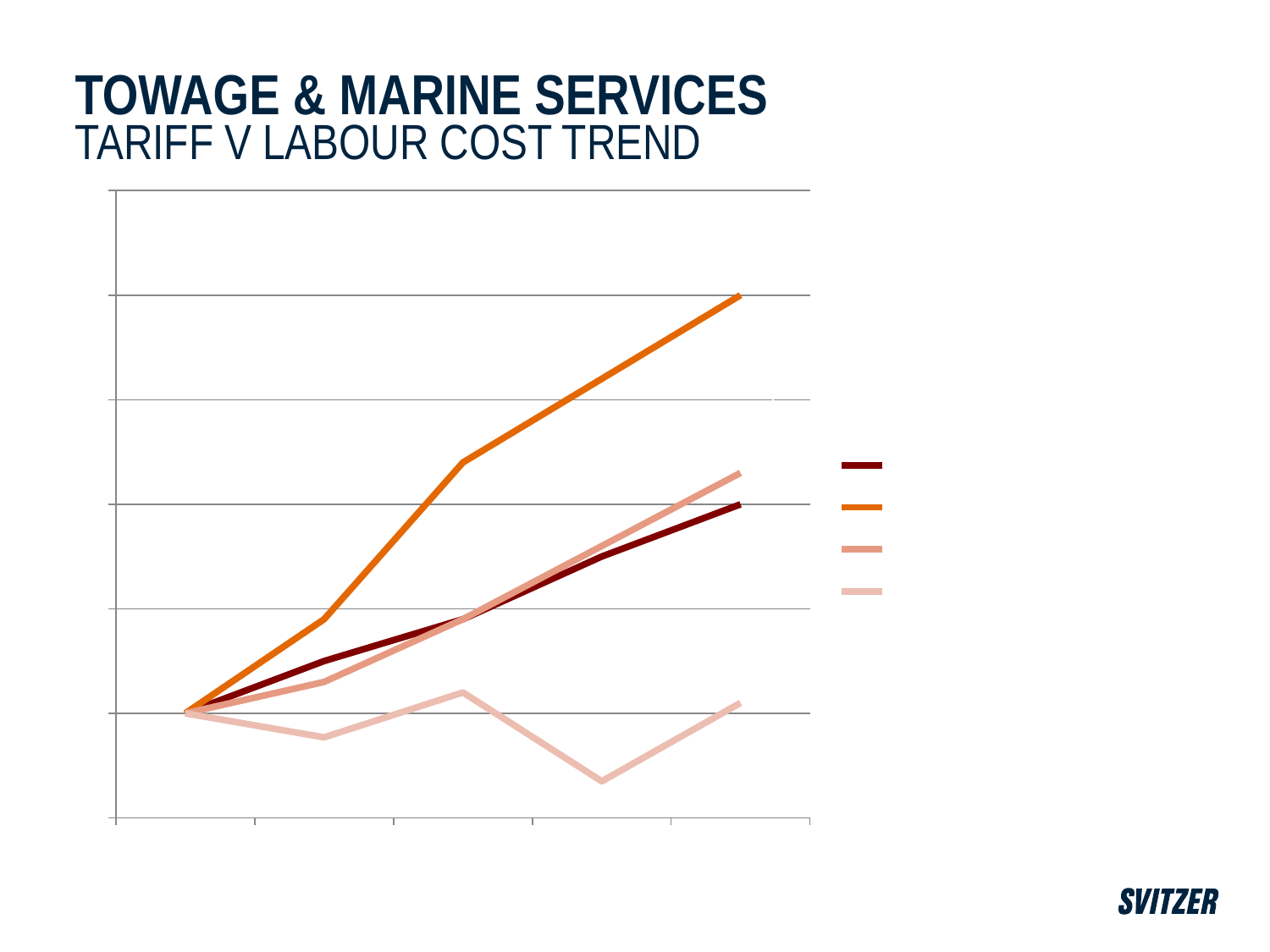
How many data points does each line have along the x axis? 5 Does the orange line rise or fall along the x axis? rise How many series does the legend list? 4 What kind of chart is shown on the slide? line chart Which line ends highest at the last point on the x axis? the orange line At the last point on the x axis, which is higher: the orange line or the dark red line? the orange line What is the title of the slide containing the chart? TOWAGE & MARINE SERVICES TARIFF V LABOUR COST TREND At the last point on the x axis, which is higher: the salmon line or the dark red line? the salmon line Which line is lowest at the last point on the x axis? the lightest pink line Do the legend entries have readable text labels? No Does the dark red line rise or fall along the x axis? rise